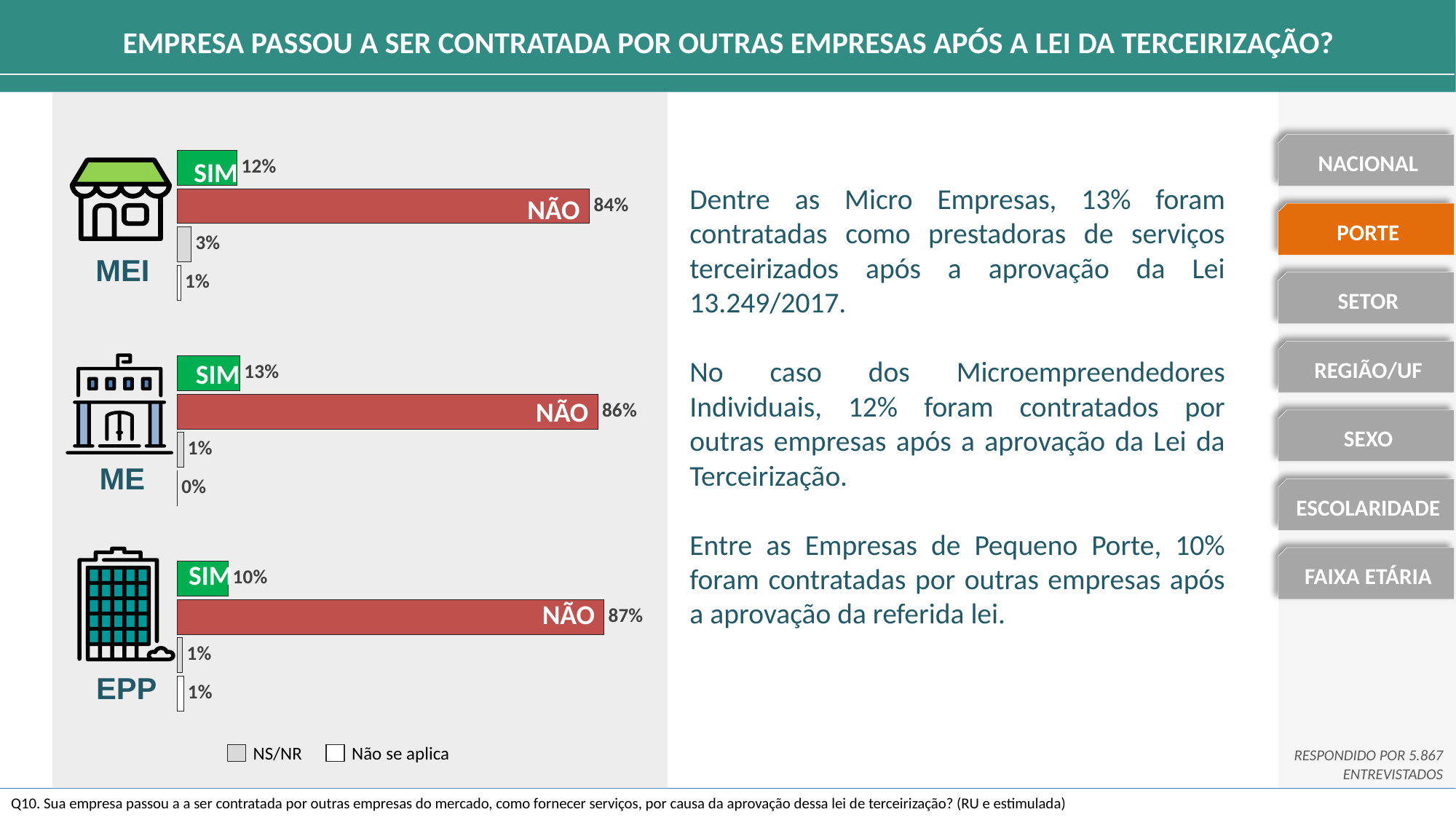
What type of chart is used to show the MEI, ME and EPP results? Bar chart In the ME chart, what percentage answered SIM? 13% In the ME chart, what is the value of the Não se aplica bar? 0% Which of the three groups (MEI, ME, EPP) has the lowest NÃO percentage? MEI How many bars are shown in the EPP chart? 4 What is the difference between the NÃO percentage for EPP and the NÃO percentage for MEI? 3% In the MEI chart, what is the value of the NS/NR bar? 3% In the MEI chart, what percentage answered NÃO? 84% Which of the three groups (MEI, ME, EPP) has the highest SIM percentage? ME Is the SIM percentage larger for MEI or for EPP? MEI In the EPP chart, what percentage answered NÃO? 87% What colour is the SIM bar in each chart? Green